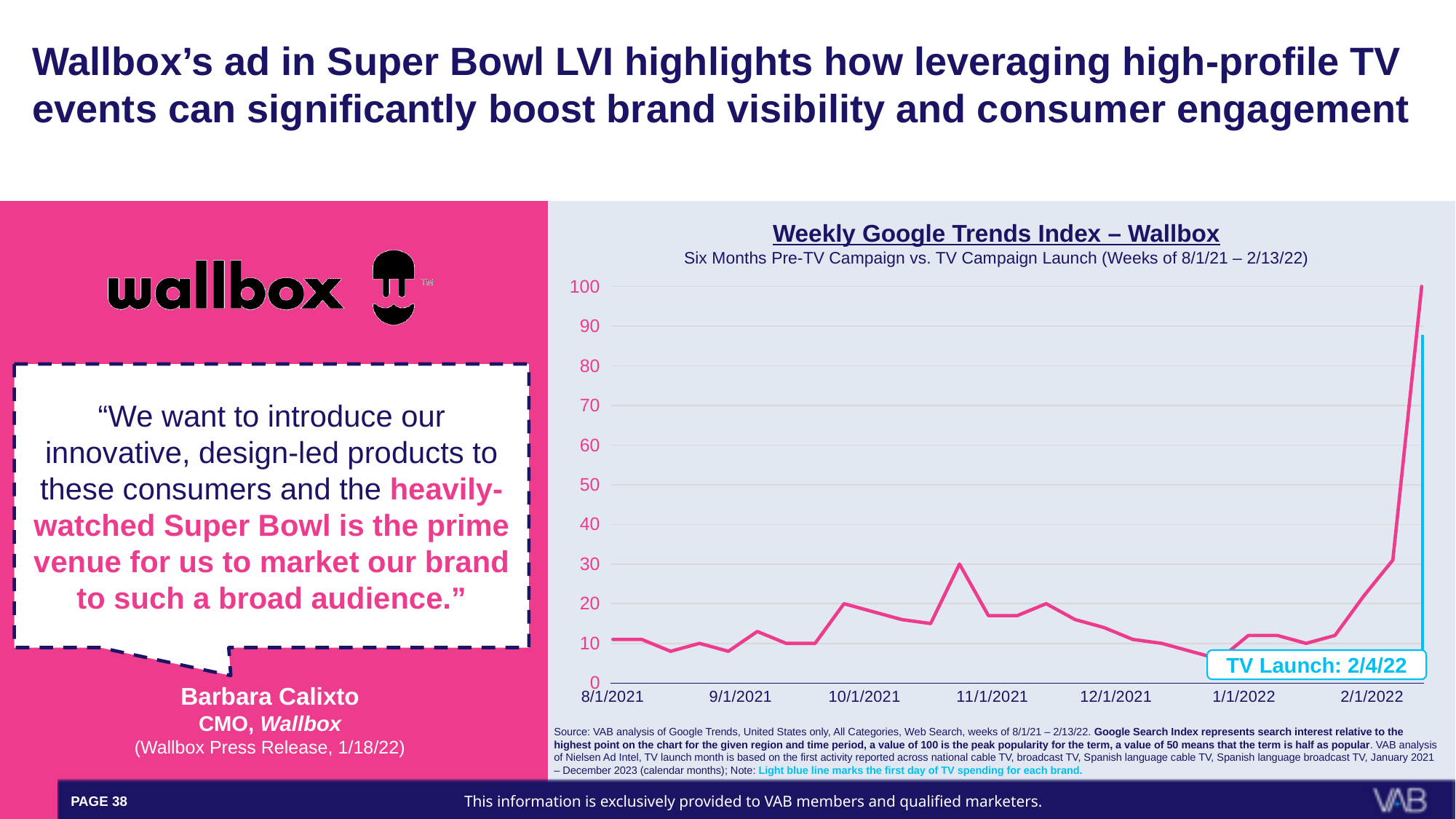
What value does the Google Trends index reach at its peak at the far right of the chart? 100 What date does the 'TV Launch' annotation on the chart give? 2/4/22 What kind of chart is shown on the slide? line chart Is the highest point of the line at the beginning or at the end of the time period? at the end Which is larger, the value for 8/1/2021 or the value for 2/1/2022? 2/1/2022 Is the value for 10/1/2021 greater or less than 10? greater Is the spike near 11/1/2021 greater or less than 20? greater Is the value for 8/1/2021 greater or less than 20? less Does the index rise or fall between 1/1/2022 and the end of the chart? rise What is the title of the chart? Weekly Google Trends Index – Wallbox